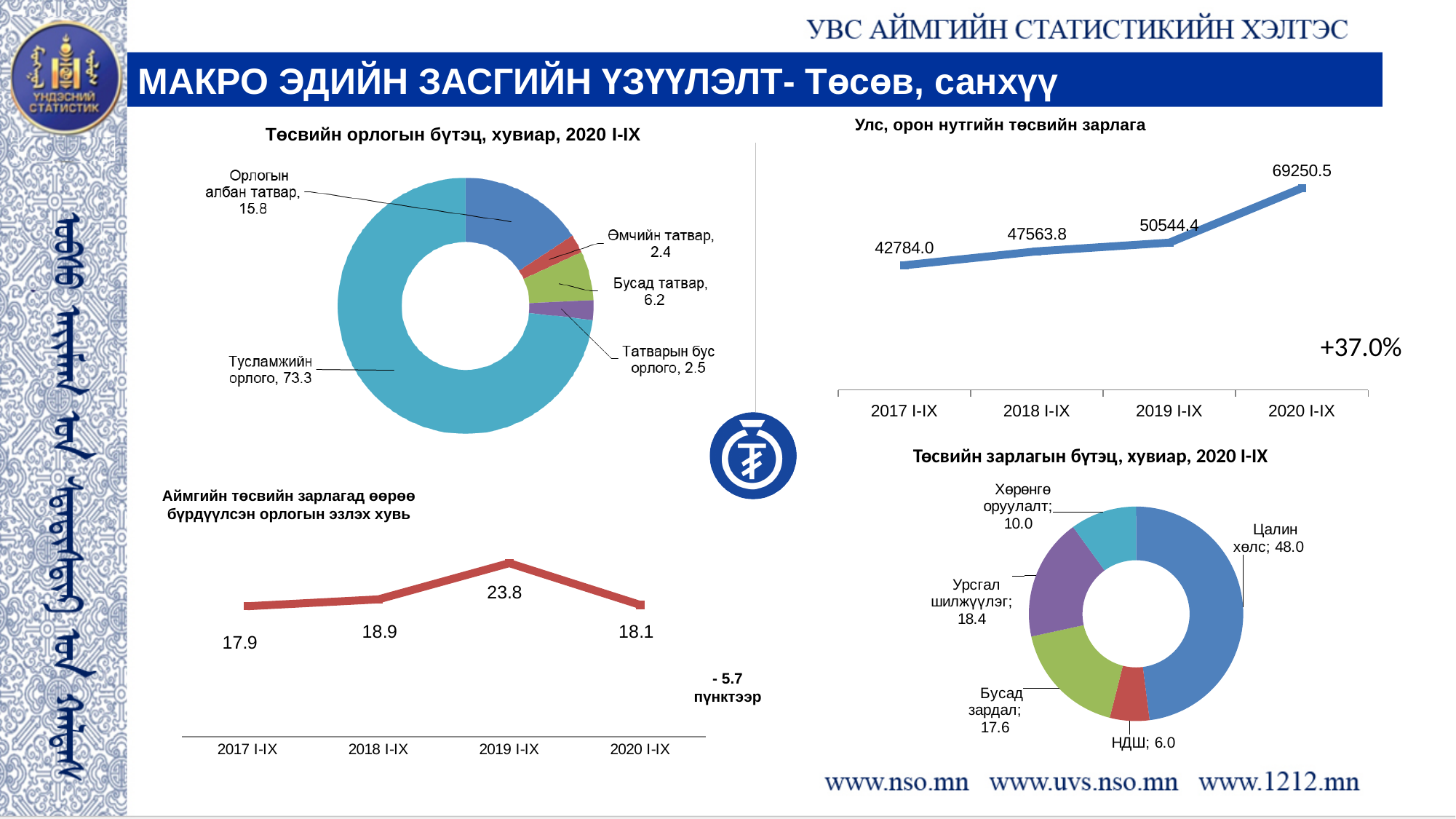
In the chart titled "Төсвийн орлогын бүтэц, хувиар, 2020 I-IX", what is the value for Тусламжийн орлого? 73.3 In the chart titled "Төсвийн зарлагын бүтэц, хувиар, 2020 I-IX", which category has the largest slice? Цалин хөлс What kind of chart is the one titled "Улс, орон нутгийн төсвийн зарлага"? line chart In the chart titled "Төсвийн орлогын бүтэц, хувиар, 2020 I-IX", which category has the smallest slice? Өмчийн татвар In the chart titled "Аймгийн төсвийн зарлагад өөрөө бүрдүүлсэн орлогын эзлэх хувь", which period has the highest value? 2019 I-IX In the chart titled "Улс, орон нутгийн төсвийн зарлага", what is the difference between the 2020 I-IX and 2017 I-IX values? 26466.5 In the chart titled "Аймгийн төсвийн зарлагад өөрөө бүрдүүлсэн орлогын эзлэх хувь", which is larger, the value for 2017 I-IX or 2020 I-IX? 2020 I-IX In the chart titled "Улс, орон нутгийн төсвийн зарлага", do the values rise or fall from 2017 I-IX to 2020 I-IX? rise In the chart titled "Төсвийн зарлагын бүтэц, хувиар, 2020 I-IX", what is the value for Урсгал шилжүүлэг? 18.4 In the chart titled "Улс, орон нутгийн төсвийн зарлага", what is the value for 2020 I-IX? 69250.5 In the chart titled "Аймгийн төсвийн зарлагад өөрөө бүрдүүлсэн орлогын эзлэх хувь", what is the value for 2018 I-IX? 18.9 In the chart titled "Төсвийн орлогын бүтэц, хувиар, 2020 I-IX", how many slices does the donut have? 5